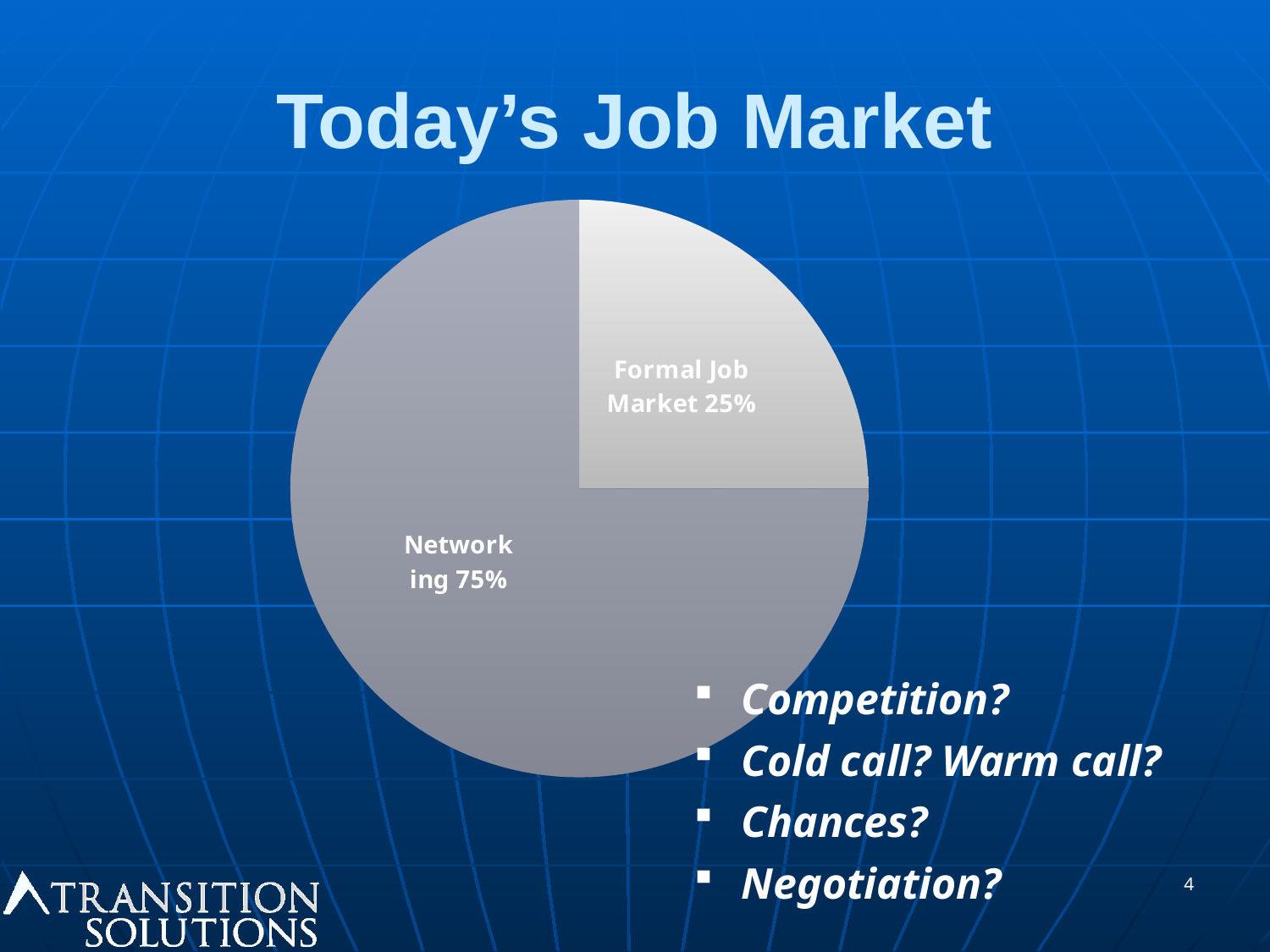
What is the title of the slide containing the pie chart? Today's Job Market How many slices does the pie chart have? 2 What share of the pie does Networking represent? 75% What is the difference in percentage points between the Networking slice and the Formal Job Market slice? 50 Which slice of the pie is the smallest? Formal Job Market What share of the pie does Formal Job Market represent? 25% What kind of chart is shown on the slide? pie chart What is the combined share of the Networking and Formal Job Market slices? 100% Which is larger, the Networking slice or the Formal Job Market slice? Networking Is the Formal Job Market slice greater or less than 50% of the pie? less Which slice of the pie is the largest? Networking